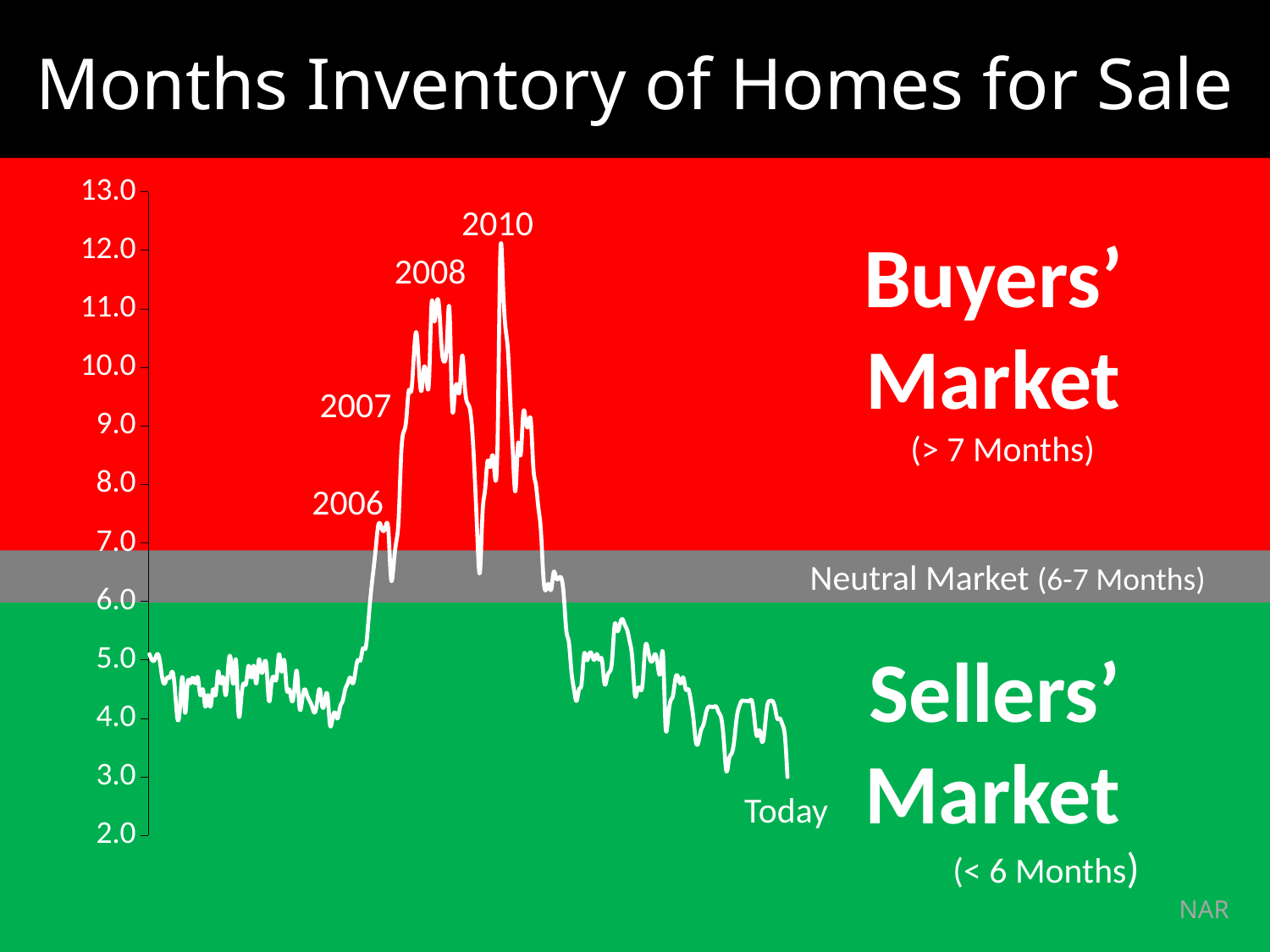
Is the peak value at 2008 greater or less than 7.0? greater Is the value at the point labeled Today greater or less than 6.0? less Which is higher, the peak at 2010 or the peak at 2008? 2010 Is the peak value at 2008 greater or less than 10.0? greater What is the title of the chart? Months Inventory of Homes for Sale Does the line rise or fall from the 2010 peak to the point labeled Today? fall Which is higher, the value at 2010 or the value at Today? 2010 What kind of chart is shown on the slide? line chart What is the highest value shown on the y axis? 13.0 Which labeled year marks the highest peak of the line? 2010